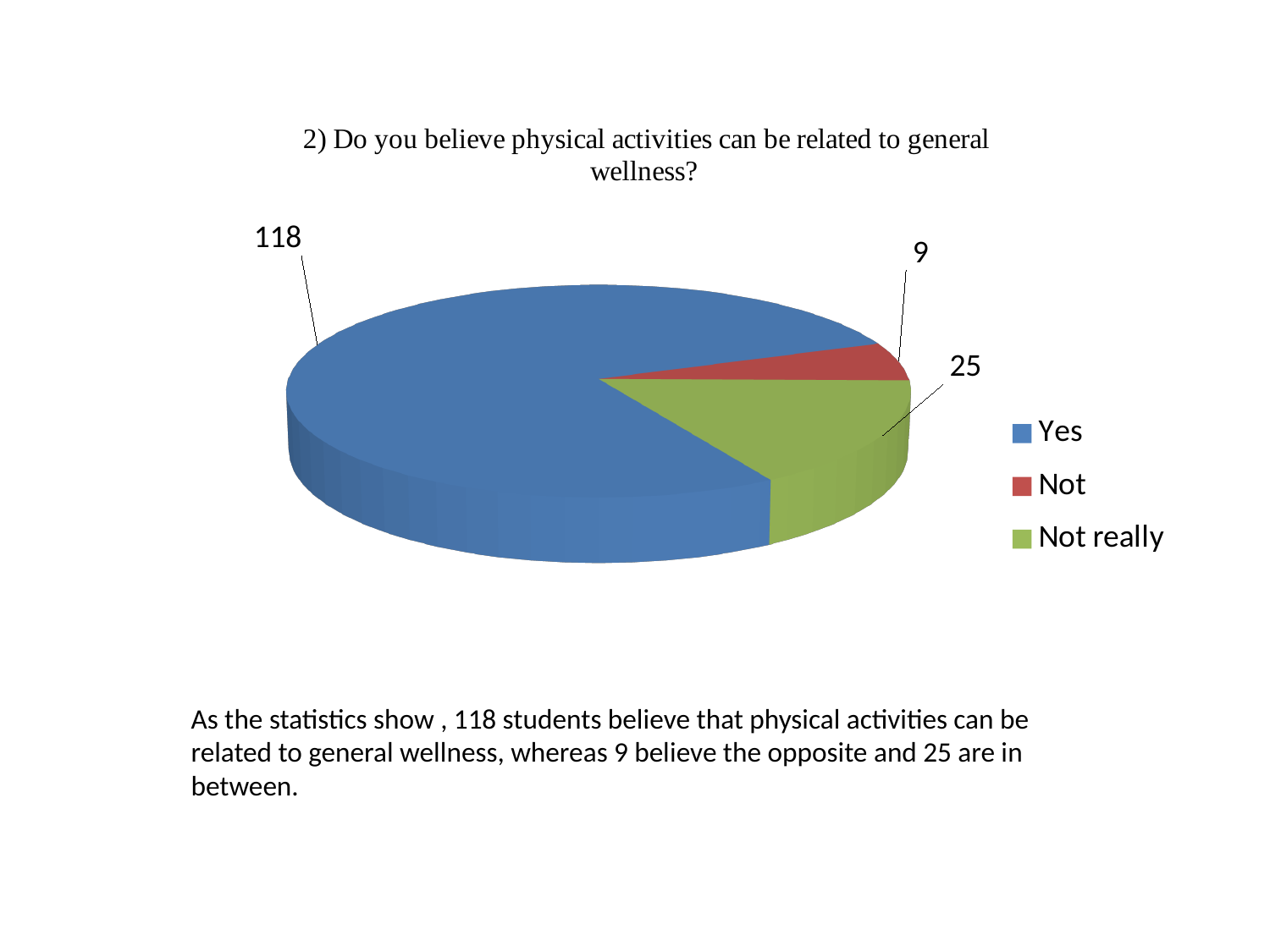
What is the difference between the "Yes" value and the "Not really" value? 93 Which is larger, the "Not really" slice or the "Not" slice? Not really What is the value for the "Yes" slice? 118 What colour is the "Not really" slice? green What is the total of all the slices in the pie chart? 152 What type of chart is shown on the slide? pie chart Which category has the largest slice? Yes What is the value for the "Not really" slice? 25 What is the value for the "Not" slice? 9 What is the difference between the "Not really" value and the "Not" value? 16 How many categories does the pie chart have? 3 Which category has the smallest slice? Not